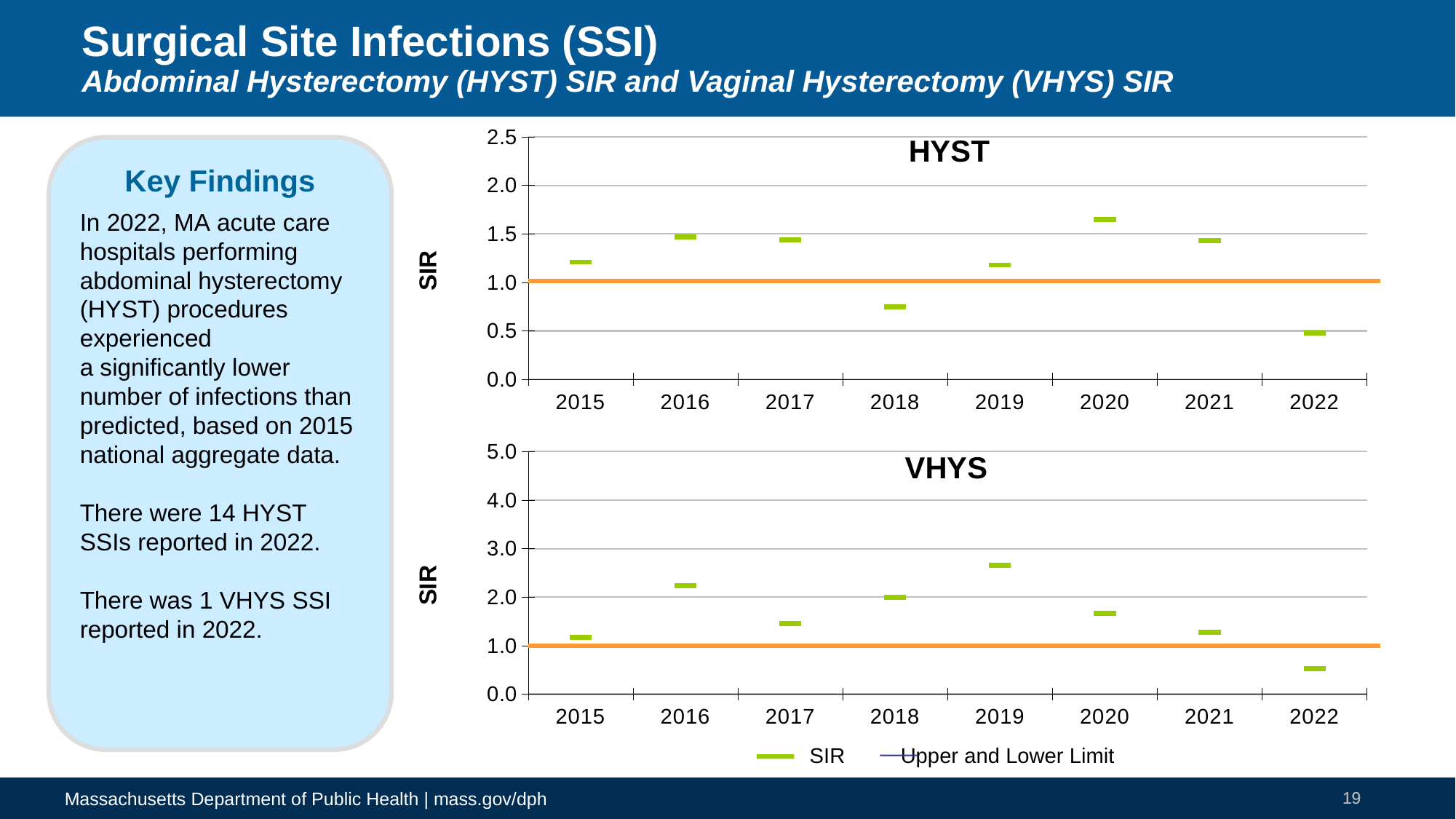
On the VHYS chart, which is larger, the SIR for 2019 or the SIR for 2021? 2019 On the VHYS chart, which year has the lowest SIR? 2022 On the HYST chart, which year has the highest SIR? 2020 On the VHYS chart, which year has the highest SIR? 2019 How many series does the legend below the VHYS chart list? 2 On the HYST chart, which is larger, the SIR for 2016 or the SIR for 2018? 2016 On the VHYS chart, is the SIR for 2022 greater or less than 1.0? less On the HYST chart, is the SIR for 2020 greater or less than 1.5? greater How many years are plotted on the HYST chart? 8 On the HYST chart, is the SIR for 2018 greater or less than 1.0? less On the HYST chart, which year has the lowest SIR? 2022